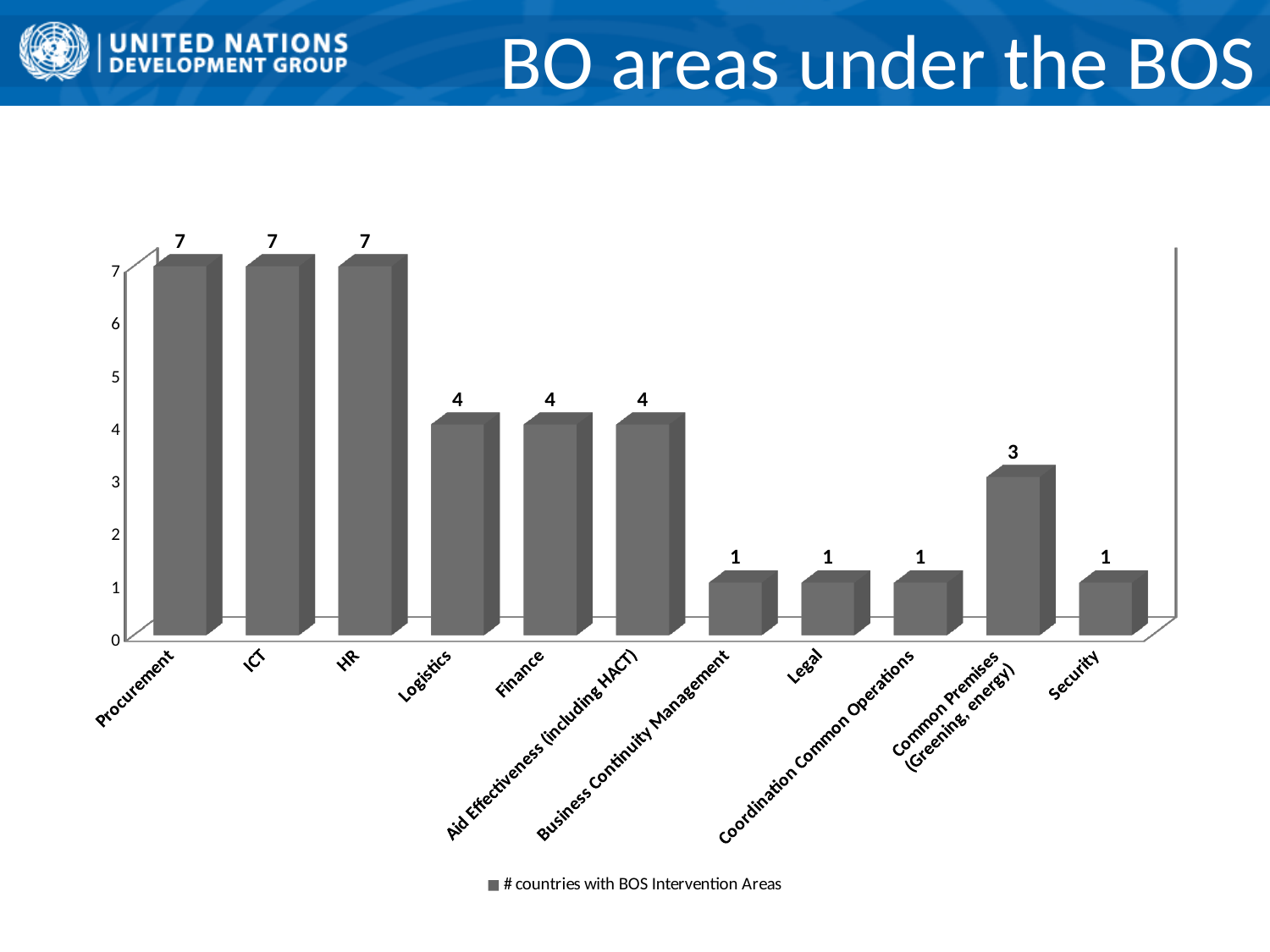
What is the value for Logistics? 4 What is the difference between the values for Procurement and Legal? 6 What kind of chart is shown on the slide? Bar chart Which is larger, the value for Common Premises (Greening, energy) or the value for Coordination Common Operations? Common Premises (Greening, energy) What is the legend entry for the series shown? # countries with BOS Intervention Areas What is the value for Security? 1 What is the value for Common Premises (Greening, energy)? 3 What is the difference between the values for Aid Effectiveness (including HACT) and Common Premises (Greening, energy)? 1 How many categories are shown on the x axis? 11 How many series does the legend list? 1 Which is larger, the value for HR or the value for Business Continuity Management? HR What is the value for Finance? 4